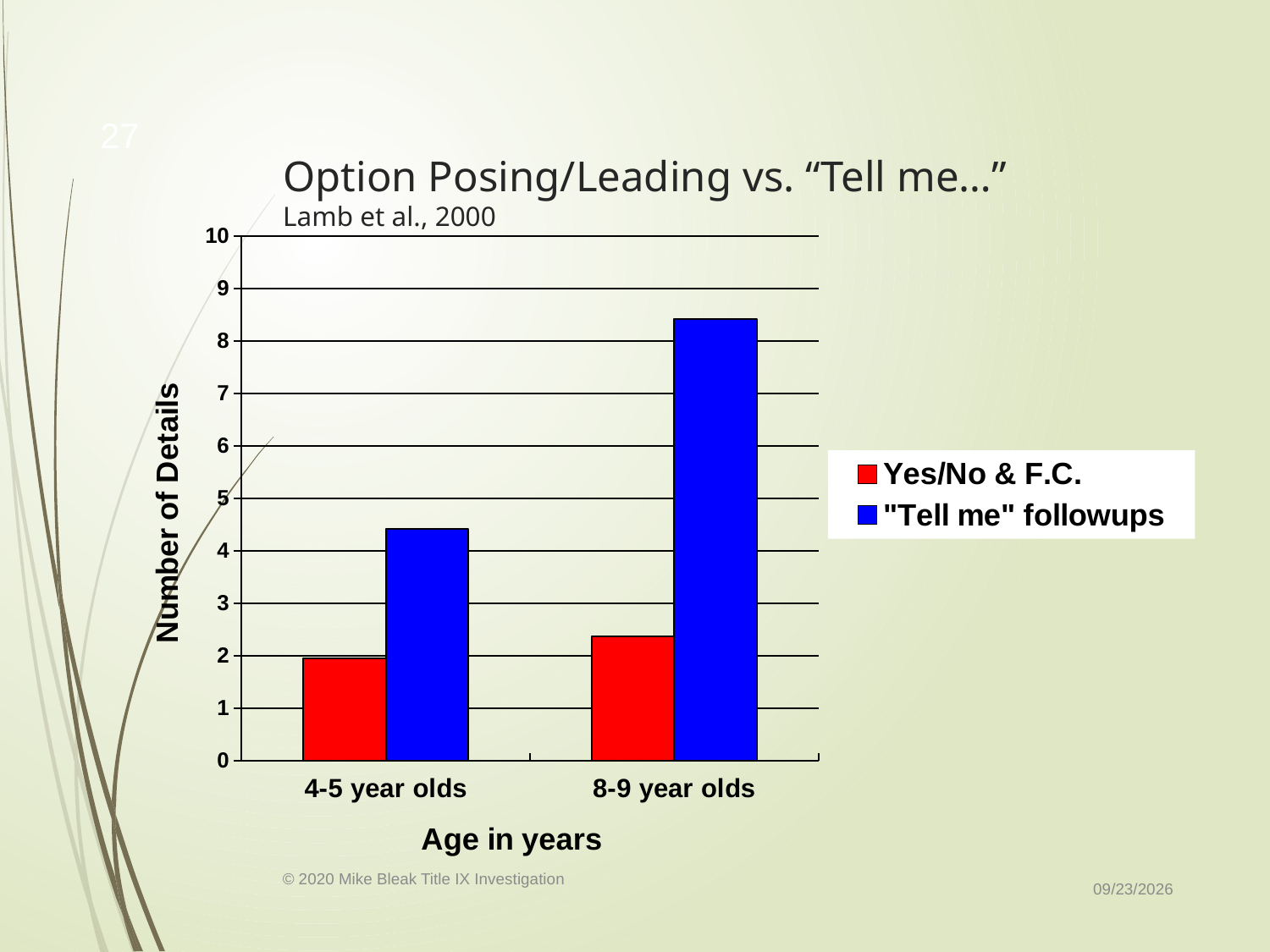
What colour represents the Yes/No & F.C. series? red For 8-9 year olds, which is larger: Yes/No & F.C. or "Tell me" followups? "Tell me" followups What kind of chart is shown on the slide? bar chart Do the "Tell me" followups values rise or fall from 4-5 year olds to 8-9 year olds? rise Is the Yes/No & F.C. value for 8-9 year olds greater or less than 3? less What is the label of the y axis? Number of Details Is the "Tell me" followups value for 4-5 year olds greater or less than 5? less Is the "Tell me" followups value for 8-9 year olds greater or less than 8? greater Which age group has the highest "Tell me" followups value? 8-9 year olds How many age categories are shown on the x axis? 2 Which age group has the lowest Yes/No & F.C. value? 4-5 year olds How many series does the legend list? 2